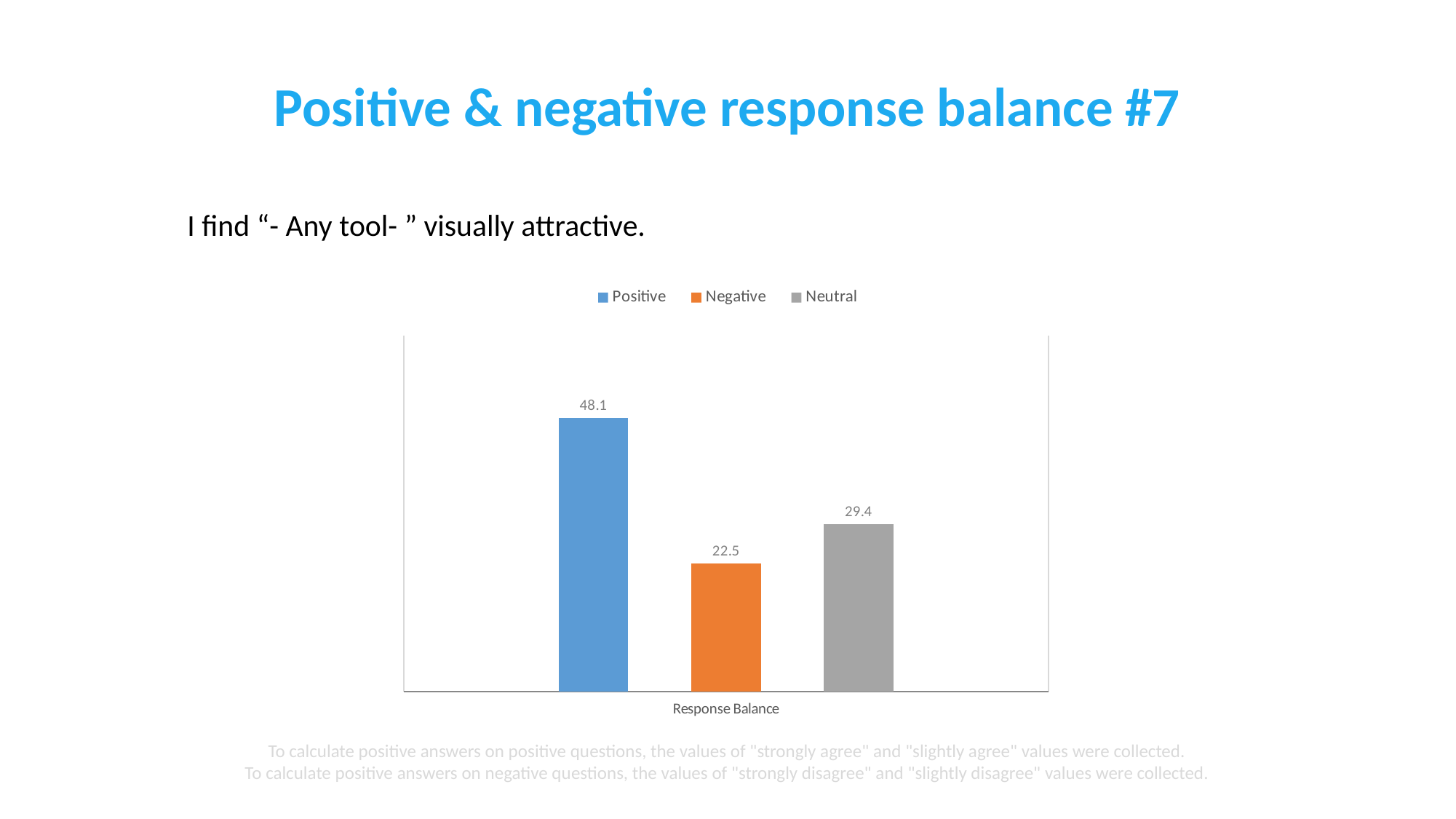
How many series does the legend list? 3 What is the difference between the Neutral and Negative values? 6.9 What is the value of the Positive bar? 48.1 Which series has the lowest value? Negative What is the difference between the Positive and Negative values? 25.6 What is the value of the Negative bar? 22.5 Which series has the highest value? Positive What kind of chart is shown on the slide? Bar chart What colour is the Negative bar? Orange Which is larger, the Neutral value or the Negative value? Neutral What is the value of the Neutral bar? 29.4 What is the label on the x axis of the chart? Response Balance